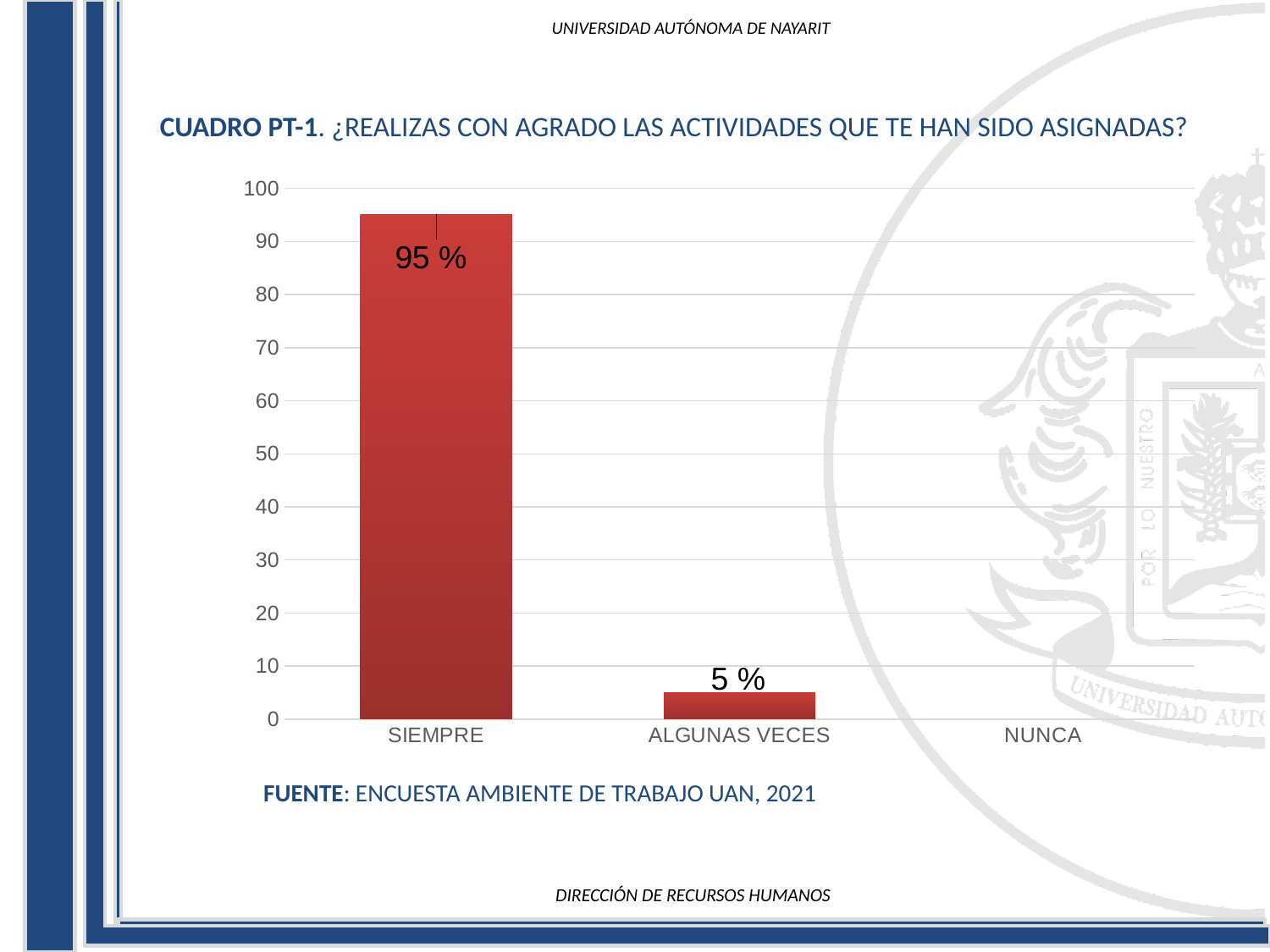
What is the value for ALGUNAS VECES? 5 % How many categories are shown on the x axis? 3 Which is larger, the value for SIEMPRE or the value for ALGUNAS VECES? SIEMPRE What is the value for SIEMPRE? 95 % What is the source cited below the chart? ENCUESTA AMBIENTE DE TRABAJO UAN, 2021 Is the value for ALGUNAS VECES greater or less than 10? less Do the values rise or fall from SIEMPRE to ALGUNAS VECES? fall What is the difference between the values for SIEMPRE and ALGUNAS VECES? 90 % What kind of chart is shown on the slide? bar chart Is the value for SIEMPRE greater or less than 90? greater What is the label of the third category on the x axis? NUNCA Which category has the highest value? SIEMPRE